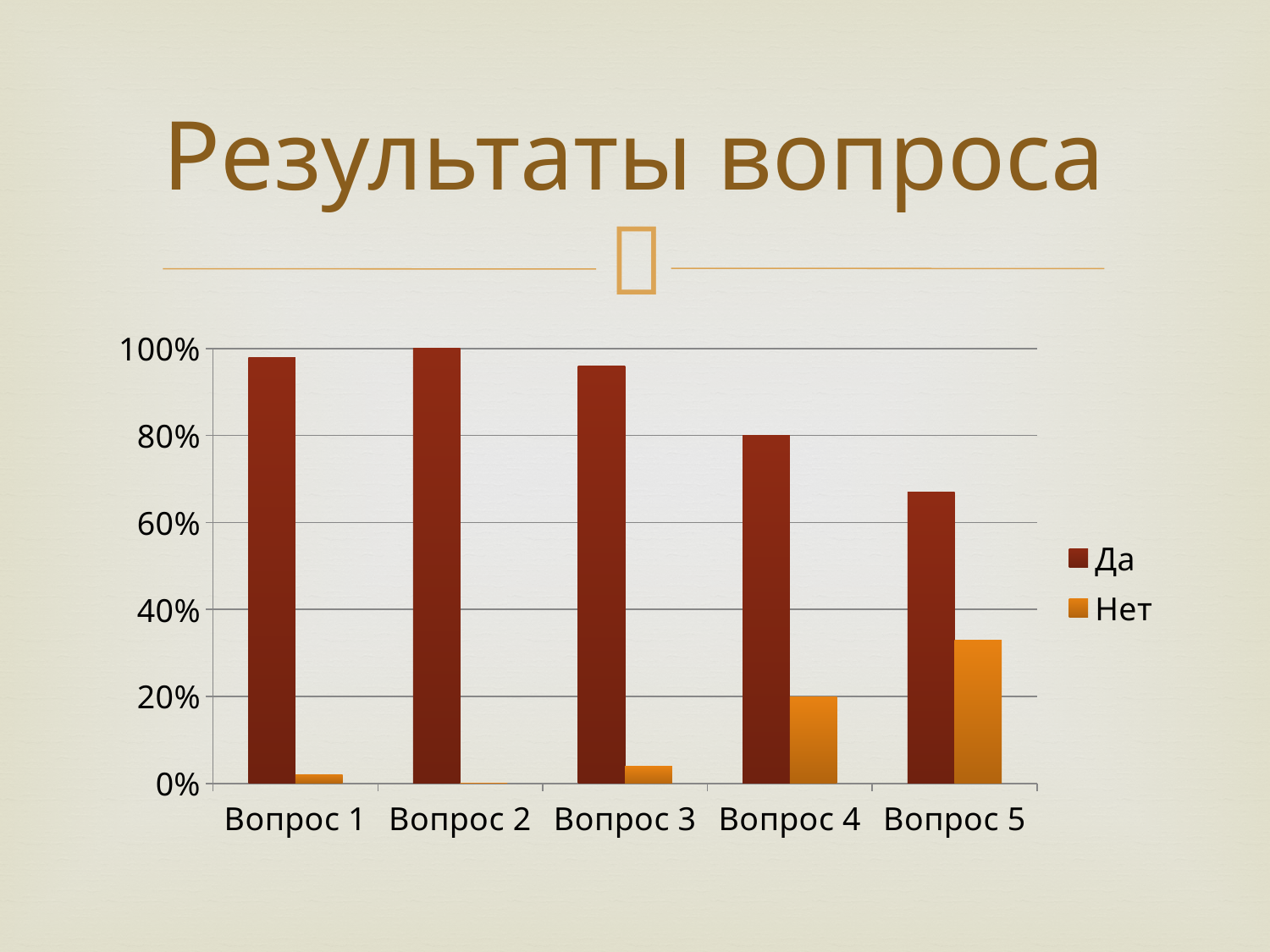
How many series does the legend list? 2 How many categories are shown on the x axis? 5 What kind of chart is shown on the slide? bar chart Do the values for Да rise or fall from Вопрос 2 to Вопрос 5? fall What is the value of Да for Вопрос 4? 80% What is the value of Нет for Вопрос 4? 20% Is the value of Да for Вопрос 5 greater or less than 60%? greater Which category has the highest value for Да? Вопрос 2 Which category has the highest value for Нет? Вопрос 5 Is the value of Нет for Вопрос 3 greater or less than 20%? less Which category has the lowest value for Да? Вопрос 5 What is the value of Да for Вопрос 2? 100%